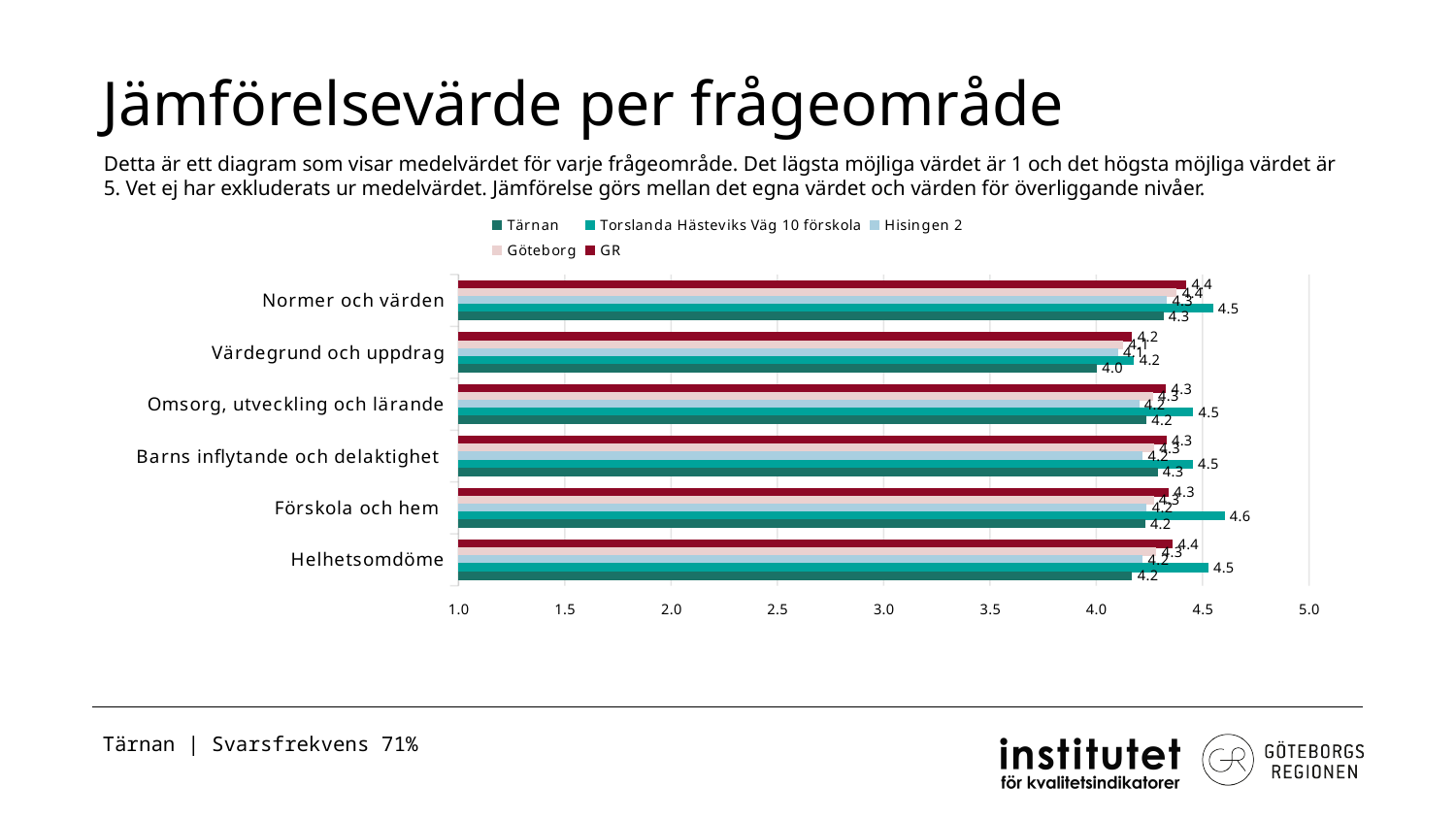
In the category Normer och värden, which is larger: the value for Tärnan or the value for Torslanda Hästeviks Väg 10 förskola? Torslanda Hästeviks Väg 10 förskola Is the value for Tärnan in the category Värdegrund och uppdrag greater or less than 4.5? less What is the value for Tärnan in the category Normer och värden? 4.3 What is the value for Torslanda Hästeviks Väg 10 förskola in the category Förskola och hem? 4.6 In which category does Tärnan have its lowest value? Värdegrund och uppdrag In which category does Torslanda Hästeviks Väg 10 förskola have its highest value? Förskola och hem How many series does the legend list? 5 What is the difference between the Torslanda Hästeviks Väg 10 förskola value and the Tärnan value in the category Förskola och hem? 0.4 What is the value for Torslanda Hästeviks Väg 10 förskola in the category Helhetsomdöme? 4.5 What kind of chart is shown on the slide? bar chart What is the value for Tärnan in the category Värdegrund och uppdrag? 4.0 How many categories (frågeområden) are shown on the chart? 6